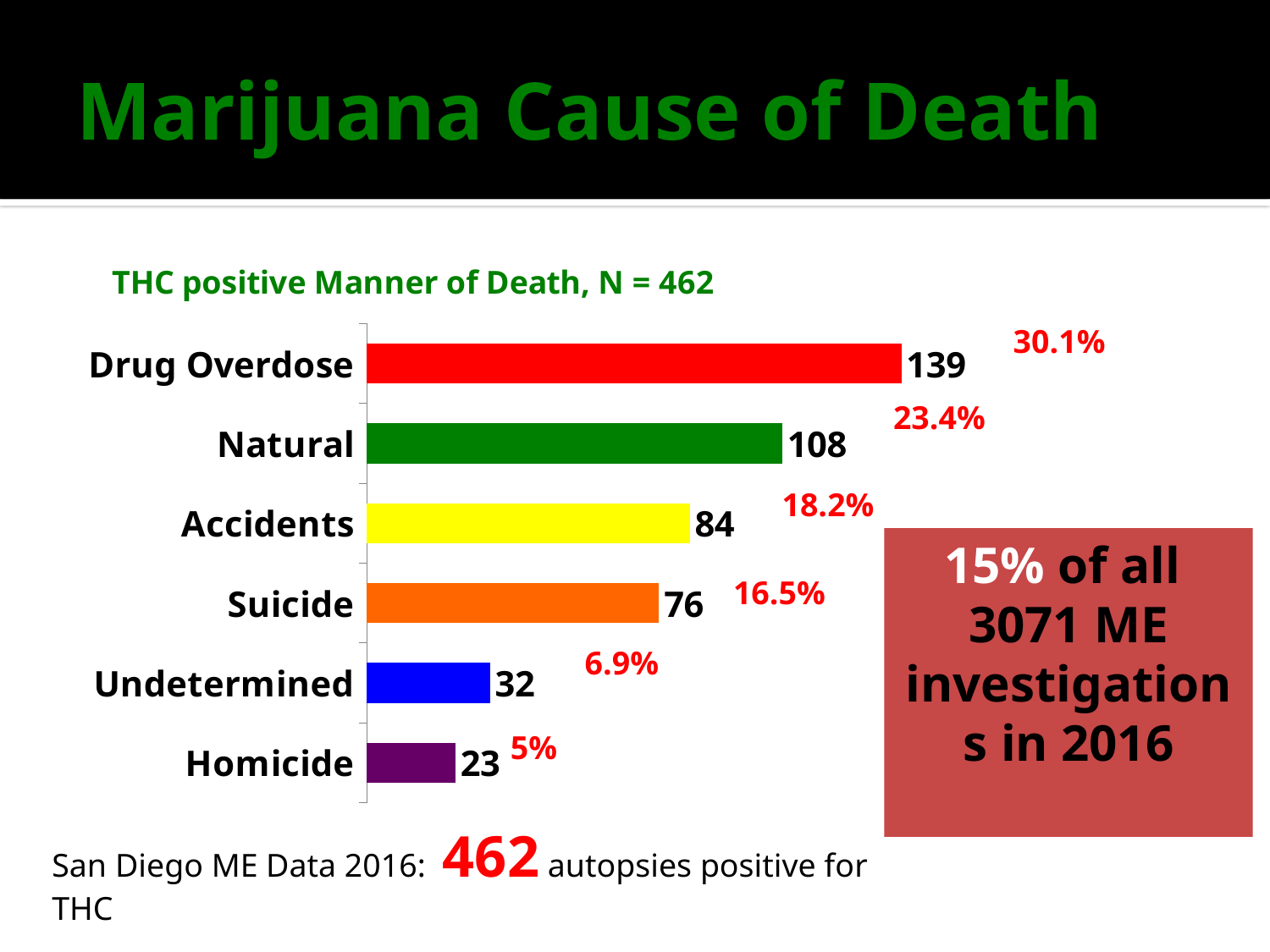
Which manner of death has the lowest value? Homicide How many categories are shown in the chart? 6 Which is larger, the value for Natural or the value for Accidents? Natural What colour is the bar for Undetermined? blue What is the title of the chart? THC positive Manner of Death, N = 462 What kind of chart is shown on the slide? bar chart Which manner of death has the highest value? Drug Overdose What is the difference between the values for Drug Overdose and Natural? 31 What is the value for Homicide? 23 What is the difference between the values for Accidents and Undetermined? 52 What is the value for Drug Overdose? 139 What is the value for Suicide? 76